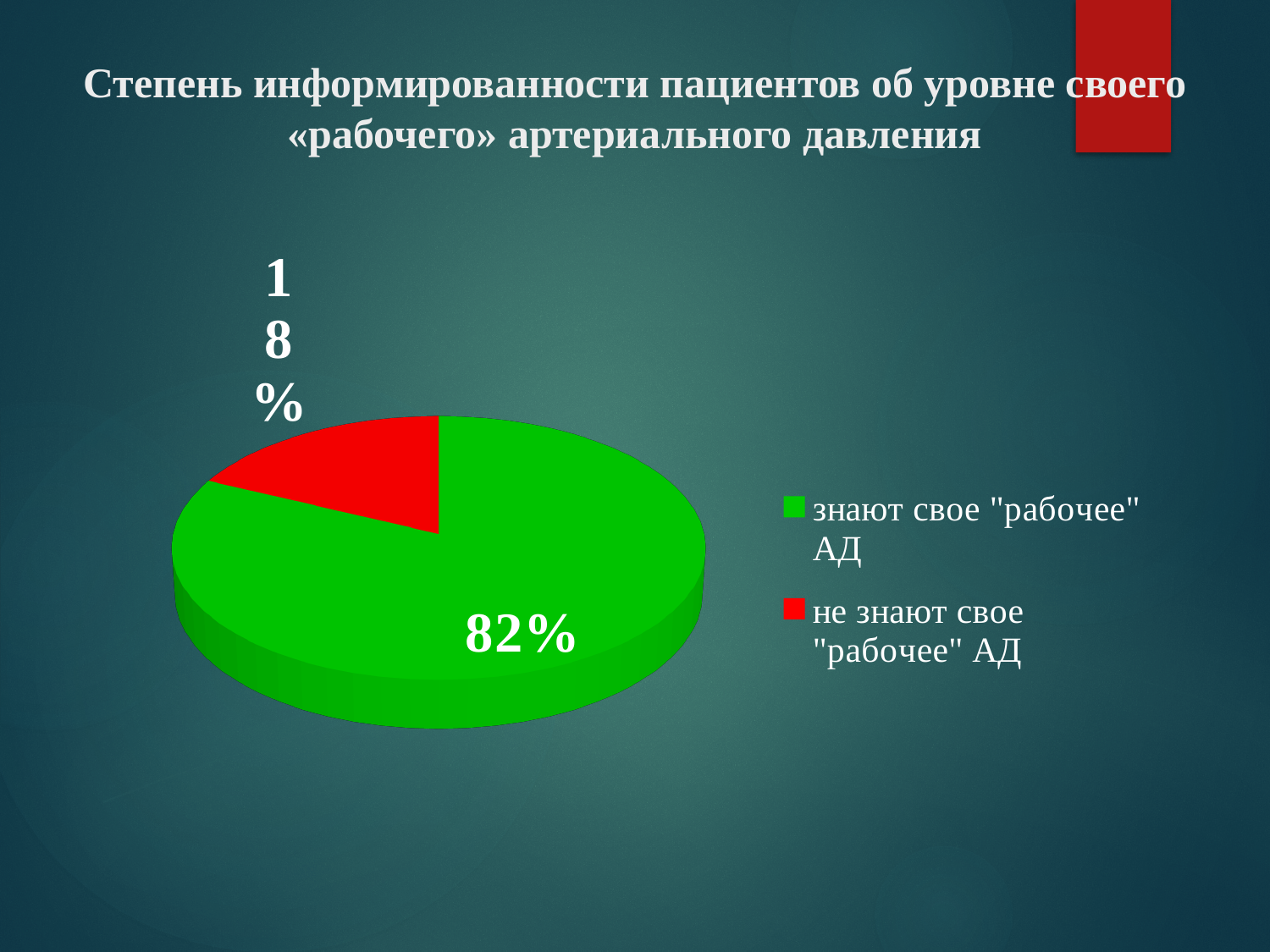
How many entries does the legend list? 2 What colour is the slice for patients who do not know their "working" blood pressure? red What kind of chart is shown on the slide? pie chart Which category has the smallest slice of the pie? не знают свое "рабочее" АД What colour is the slice for patients who know their "working" blood pressure? green How many slices does the pie chart have? 2 What is the difference in percentage points between the share who know and the share who do not know their "working" blood pressure? 64 Which category has the largest slice of the pie? знают свое "рабочее" АД What share of patients know their "working" blood pressure (знают свое "рабочее" АД)? 82% Which is larger: the share who know their "working" blood pressure or the share who do not? знают свое "рабочее" АД What share of patients do not know their "working" blood pressure (не знают свое "рабочее" АД)? 18%